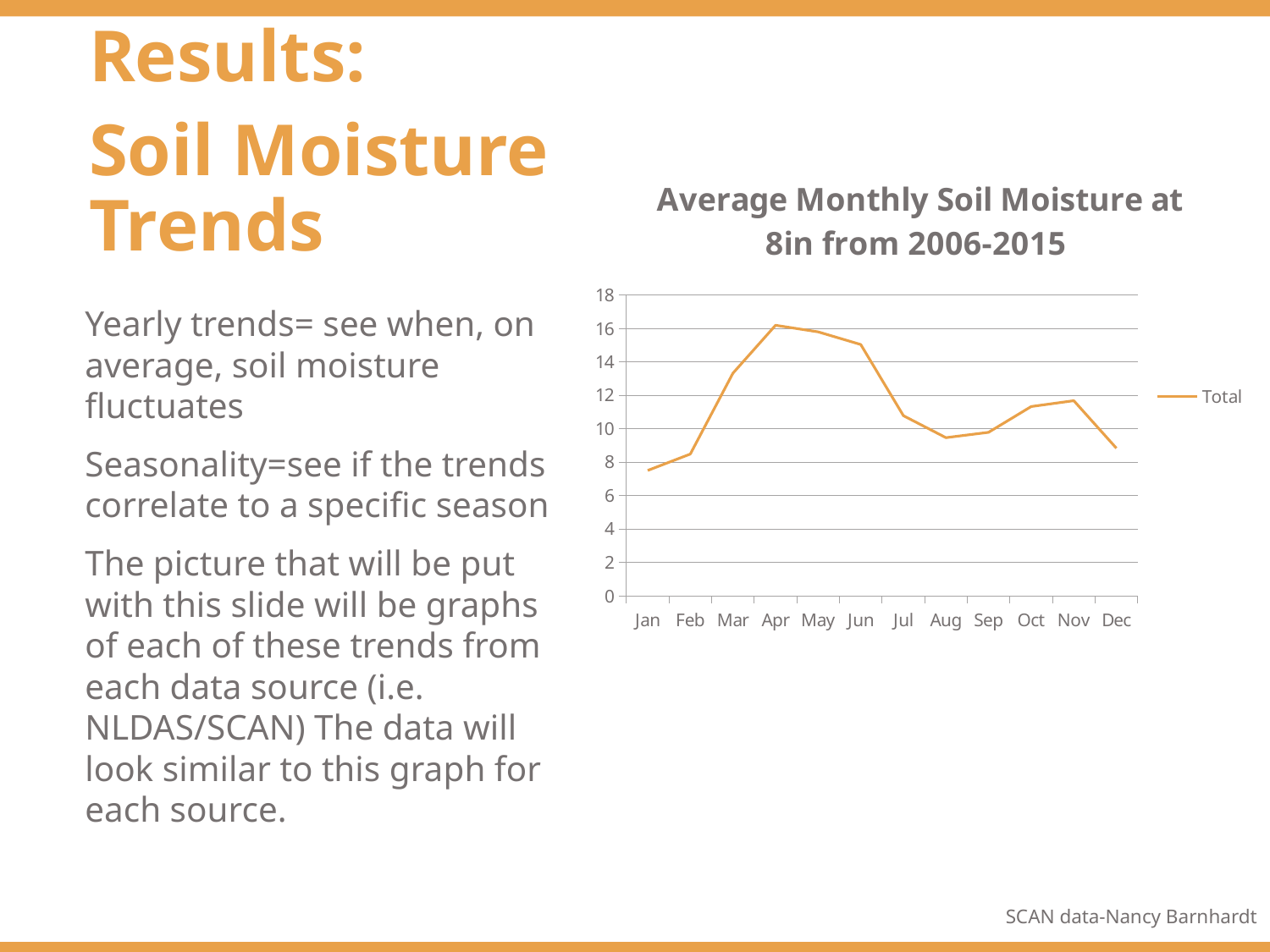
Is the value for Jun greater or less than 14? greater Do the values rise or fall from Jun to Aug? fall Is the value for Aug greater or less than 10? less What kind of chart is shown on the slide? line chart Which is larger, the value for Mar or the value for Jul? Mar How many months are plotted along the x axis of the chart? 12 Which month has the highest average soil moisture in the chart? Apr What is the title of the chart? Average Monthly Soil Moisture at 8in from 2006-2015 Is the value for Jan greater or less than 8? less Which month has the lowest average soil moisture in the chart? Jan How many series does the chart's legend list? 1